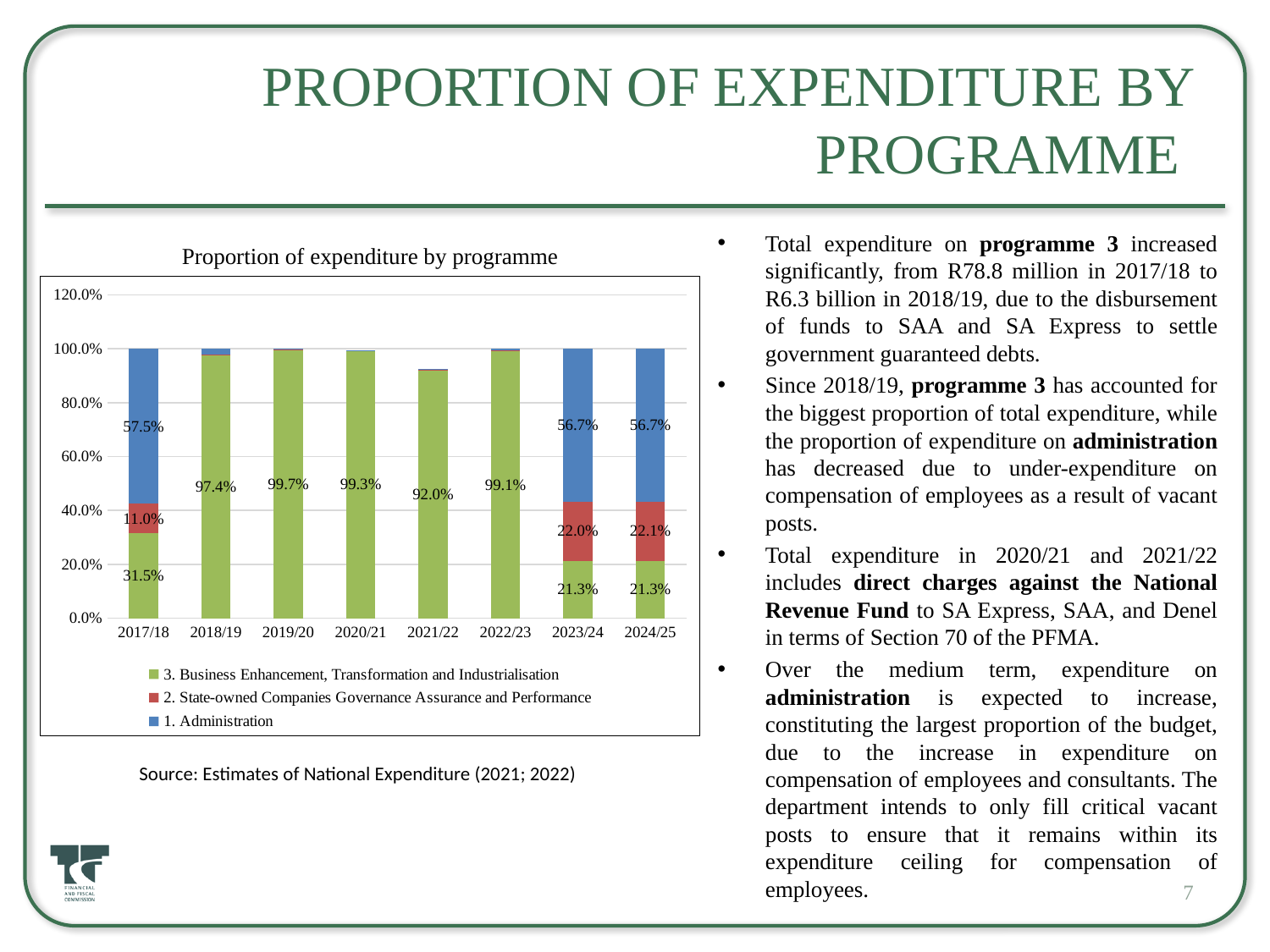
How many years are shown on the x axis? 8 What is the difference between the 1. Administration value and the 2. State-owned Companies Governance Assurance and Performance value in 2017/18? 46.5% What is the total of the stacked bar for 2017/18? 100.0% What is the value for 2. State-owned Companies Governance Assurance and Performance in 2024/25? 22.1% What is the title of the chart? Proportion of expenditure by programme In which year is the value for 3. Business Enhancement, Transformation and Industrialisation highest? 2019/20 What is the value for 3. Business Enhancement, Transformation and Industrialisation in 2021/22? 92.0% What is the value for 3. Business Enhancement, Transformation and Industrialisation in 2017/18? 31.5% In 2017/18, which is larger: the value for 1. Administration or the value for 3. Business Enhancement, Transformation and Industrialisation? 1. Administration What kind of chart is shown? Stacked bar chart What is the value for 1. Administration in 2023/24? 56.7% How many series does the legend list? 3